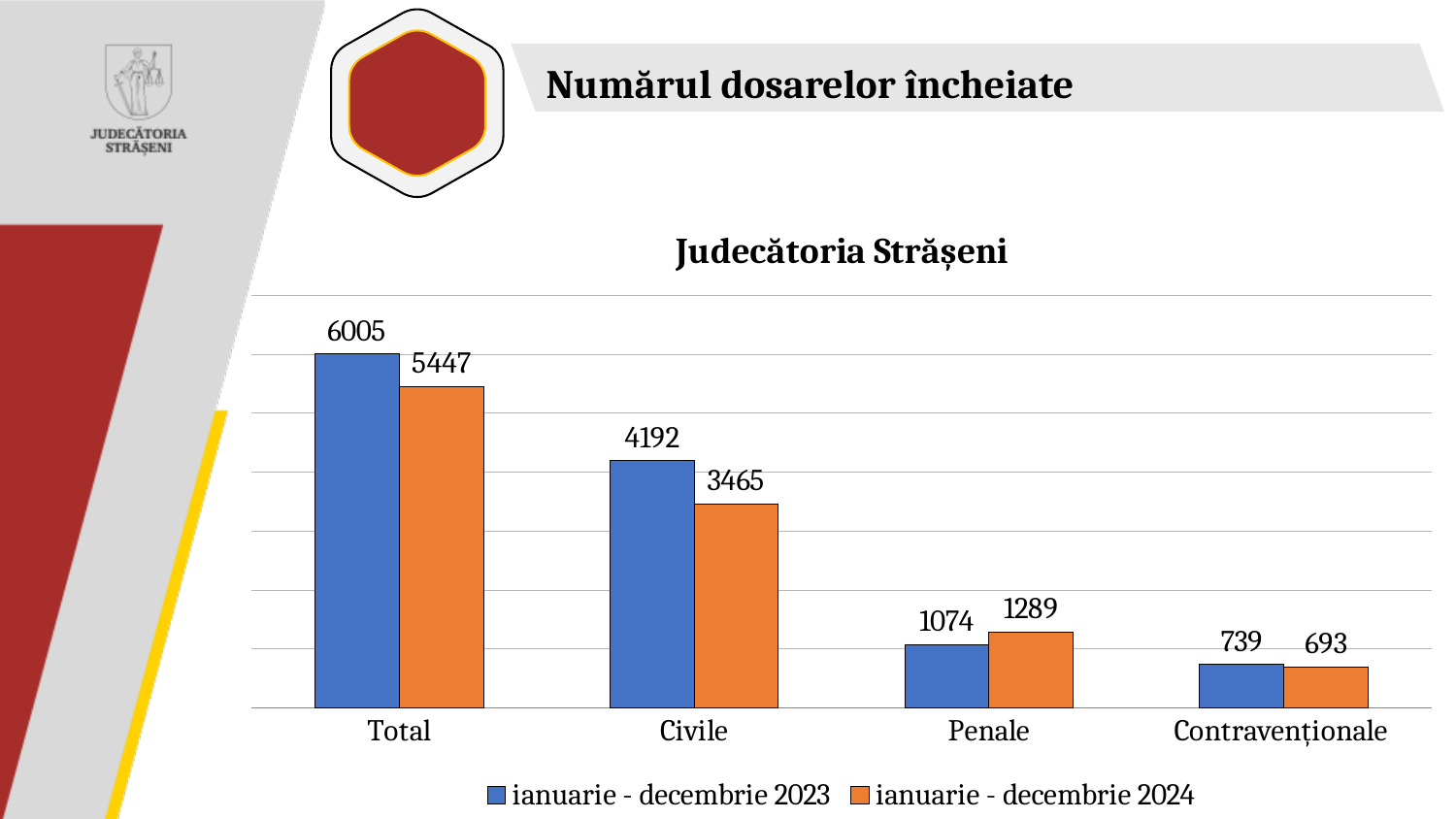
Excluding Total, which category has the highest value in the ianuarie - decembrie 2023 series? Civile How many categories are shown on the x axis? 4 What kind of chart is shown on the slide? Bar chart What is the value for Contravenționale in the ianuarie - decembrie 2023 series? 739 What is the Total value for ianuarie - decembrie 2024? 5447 How many series does the legend list? 2 For Penale, which series has the larger value: ianuarie - decembrie 2023 or ianuarie - decembrie 2024? ianuarie - decembrie 2024 What is the difference between the Civile values for 2023 and 2024? 727 Which category has the lowest value in the ianuarie - decembrie 2024 series? Contravenționale What is the value for Penale in the ianuarie - decembrie 2024 series? 1289 What is the difference between the Total values for 2023 and 2024? 558 What is the value for Civile in the ianuarie - decembrie 2023 series? 4192